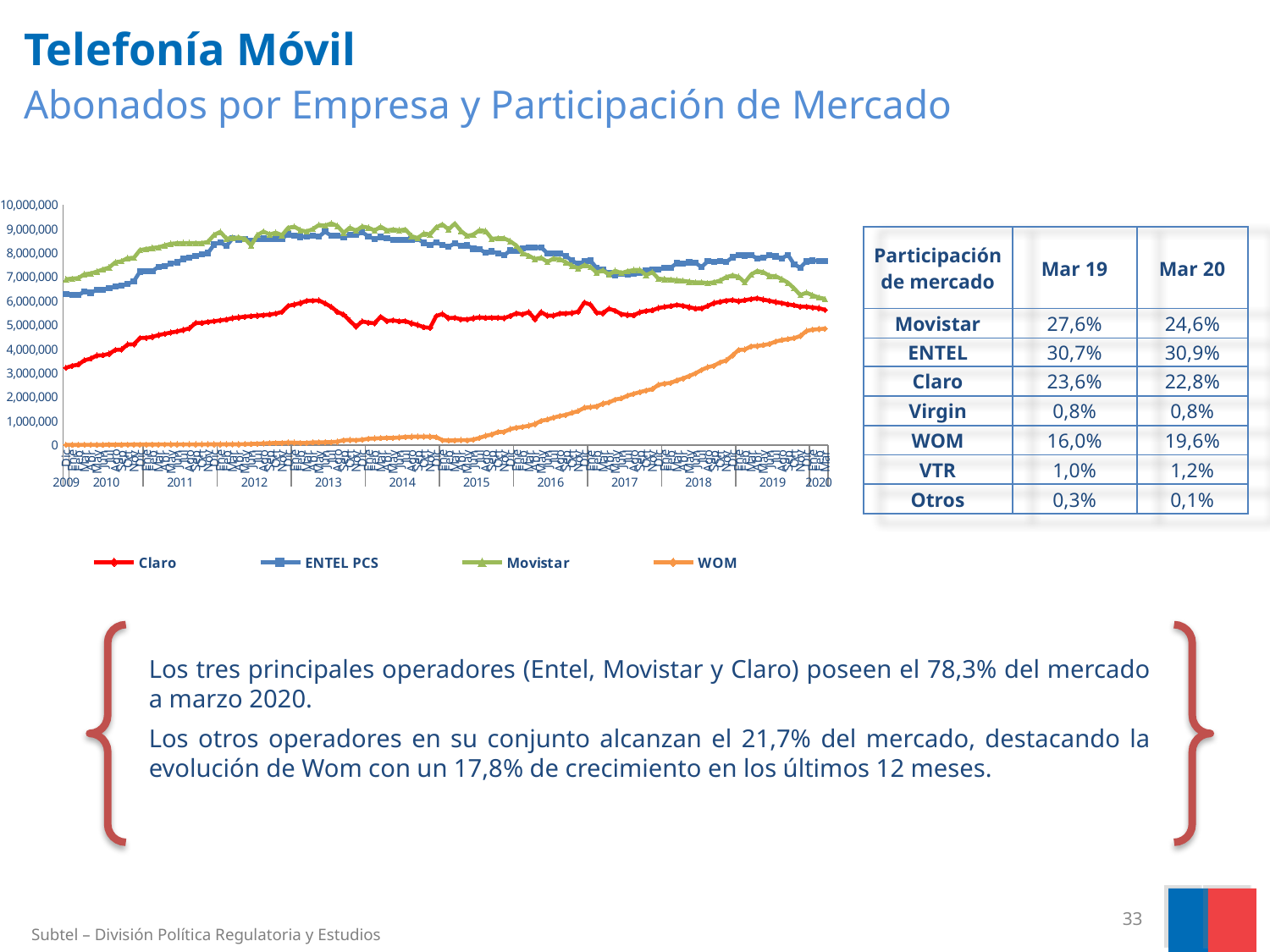
Is the value for WOM at the end of the series in 2020 greater or less than 4,000,000? greater Which series has the highest value at the end of the series in 2020? ENTEL PCS How many series does the chart's legend list? 4 At the end of the series in 2020, which is higher, ENTEL PCS or Movistar? ENTEL PCS What colour is the WOM line in the chart? orange What kind of chart is shown on the slide? line chart Does the WOM line rise or fall between 2015 and 2020? rise Is the value for ENTEL PCS at the end of the series in 2020 greater or less than 7,000,000? greater Does the Movistar line rise or fall between 2014 and 2020? fall Is the value for Claro at the start of the series in 2009 greater or less than 4,000,000? less Which series has the lowest values in 2009? WOM Which series are listed in the chart's legend? Claro, ENTEL PCS, Movistar, WOM